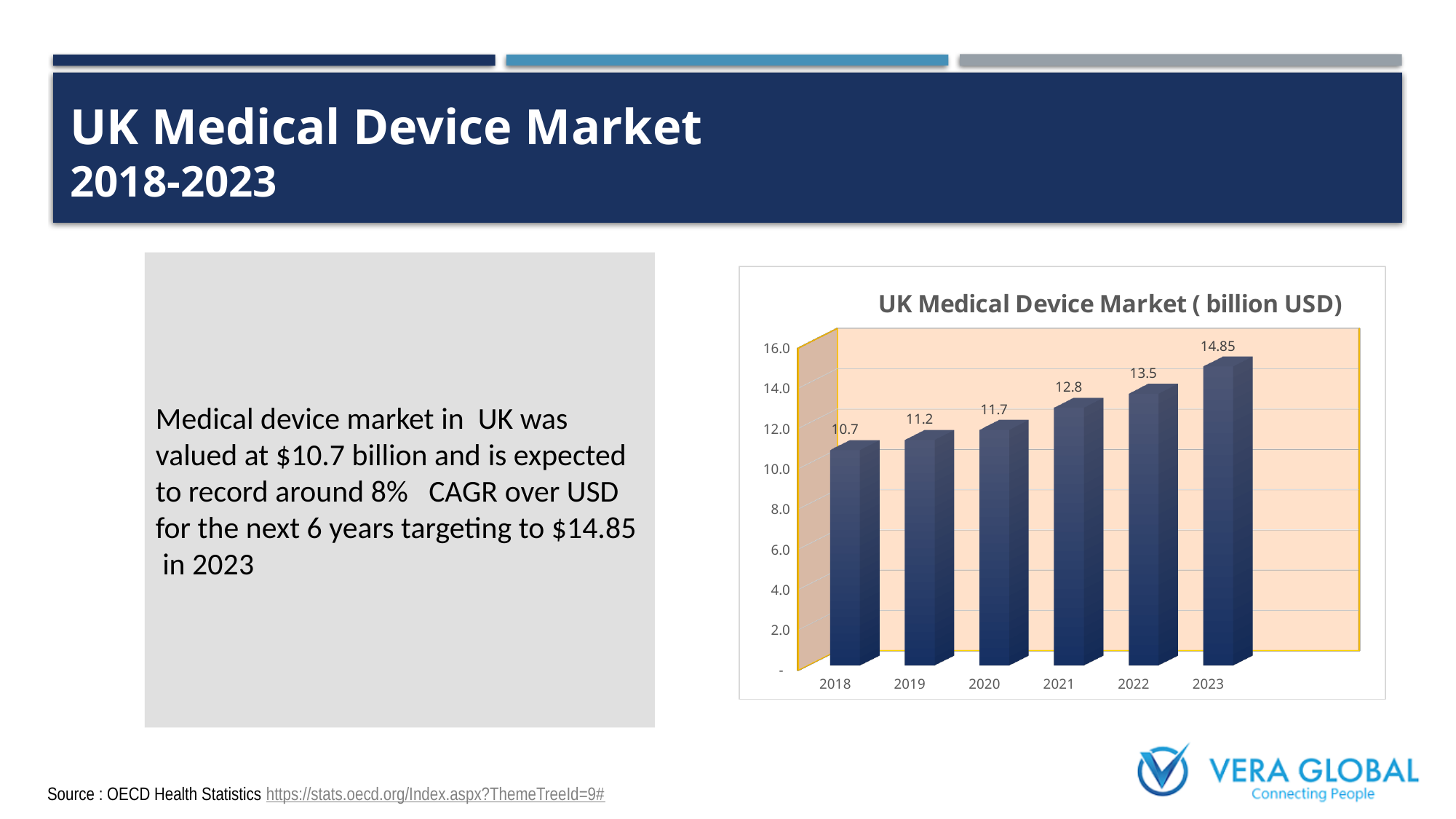
Which is larger in the UK Medical Device Market chart, the value for 2022 or the value for 2020? 2022 What is the difference between the 2023 and 2018 values in the UK Medical Device Market chart? 4.15 How many years are shown on the x axis of the UK Medical Device Market chart? 6 Which year has the highest value in the UK Medical Device Market chart? 2023 Is the value for 2021 in the UK Medical Device Market chart greater or less than 12.0? greater What kind of chart is the UK Medical Device Market chart? Bar chart What is the difference between the 2020 and 2019 values in the UK Medical Device Market chart? 0.5 What is the value for 2021 in the UK Medical Device Market chart? 12.8 Do the values in the UK Medical Device Market chart rise or fall from 2018 to 2023? Rise Which year has the lowest value in the UK Medical Device Market chart? 2018 What is the value for 2018 in the UK Medical Device Market chart? 10.7 What is the value for 2023 in the UK Medical Device Market chart? 14.85